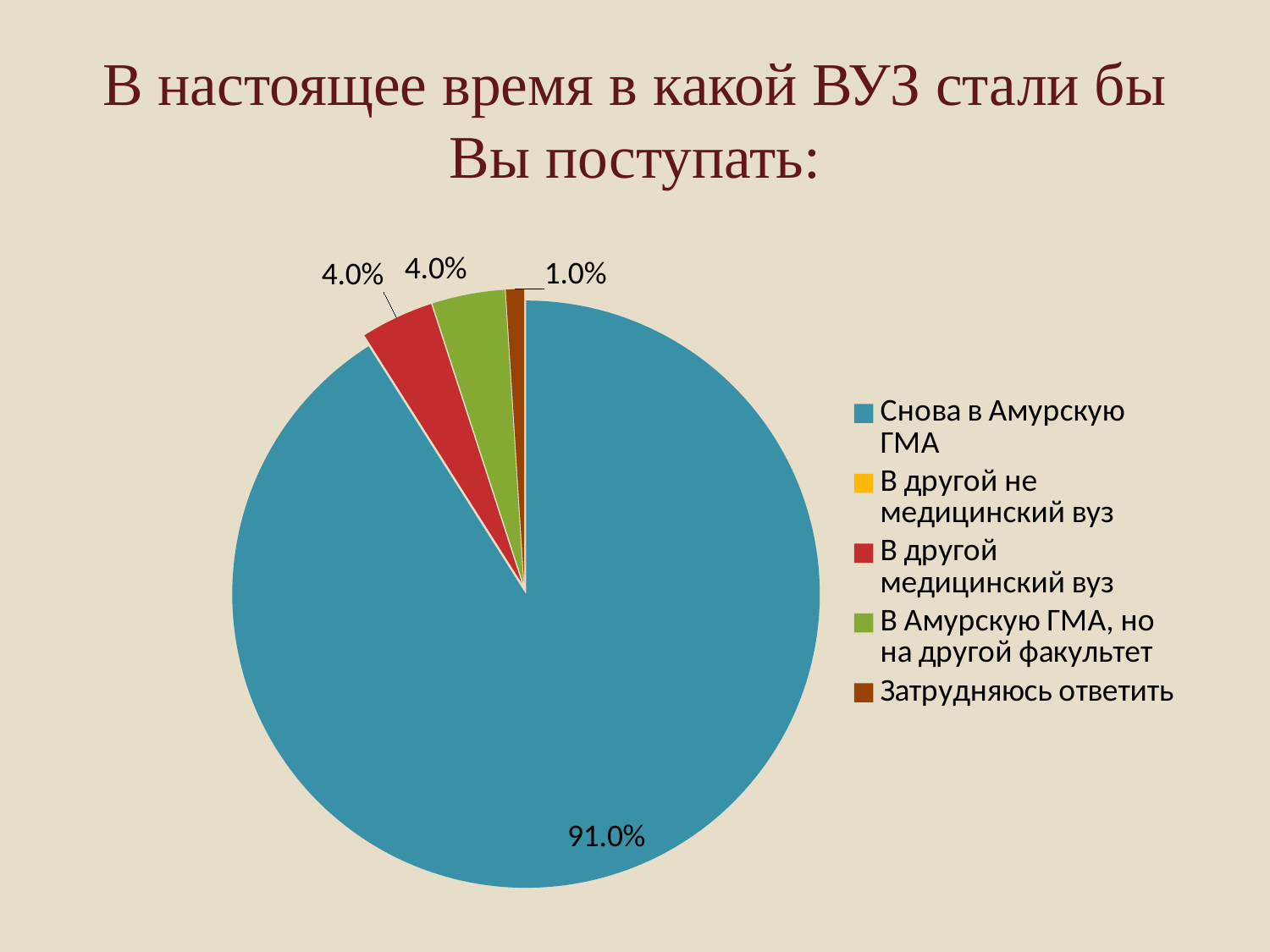
What is the difference in percentage points between "Снова в Амурскую ГМА" and "В другой медицинский вуз"? 87.0% Which answer option has the largest share of the pie? Снова в Амурскую ГМА Of the slices with printed percentage labels, which one is the smallest? Затрудняюсь ответить What colour is the slice for "Снова в Амурскую ГМА"? Blue What is the difference in percentage points between "Снова в Амурскую ГМА" and "Затрудняюсь ответить"? 90.0% What percentage is shown for "В Амурскую ГМА, но на другой факультет"? 4.0% What percentage of respondents chose "Снова в Амурскую ГМА"? 91.0% Which is larger: the share for "В Амурскую ГМА, но на другой факультет" or the share for "Затрудняюсь ответить"? В Амурскую ГМА, но на другой факультет What percentage is shown for "Затрудняюсь ответить"? 1.0% What percentage is shown for "В другой медицинский вуз"? 4.0% What type of chart is shown on the slide? Pie chart How many answer options are listed in the chart legend? 5